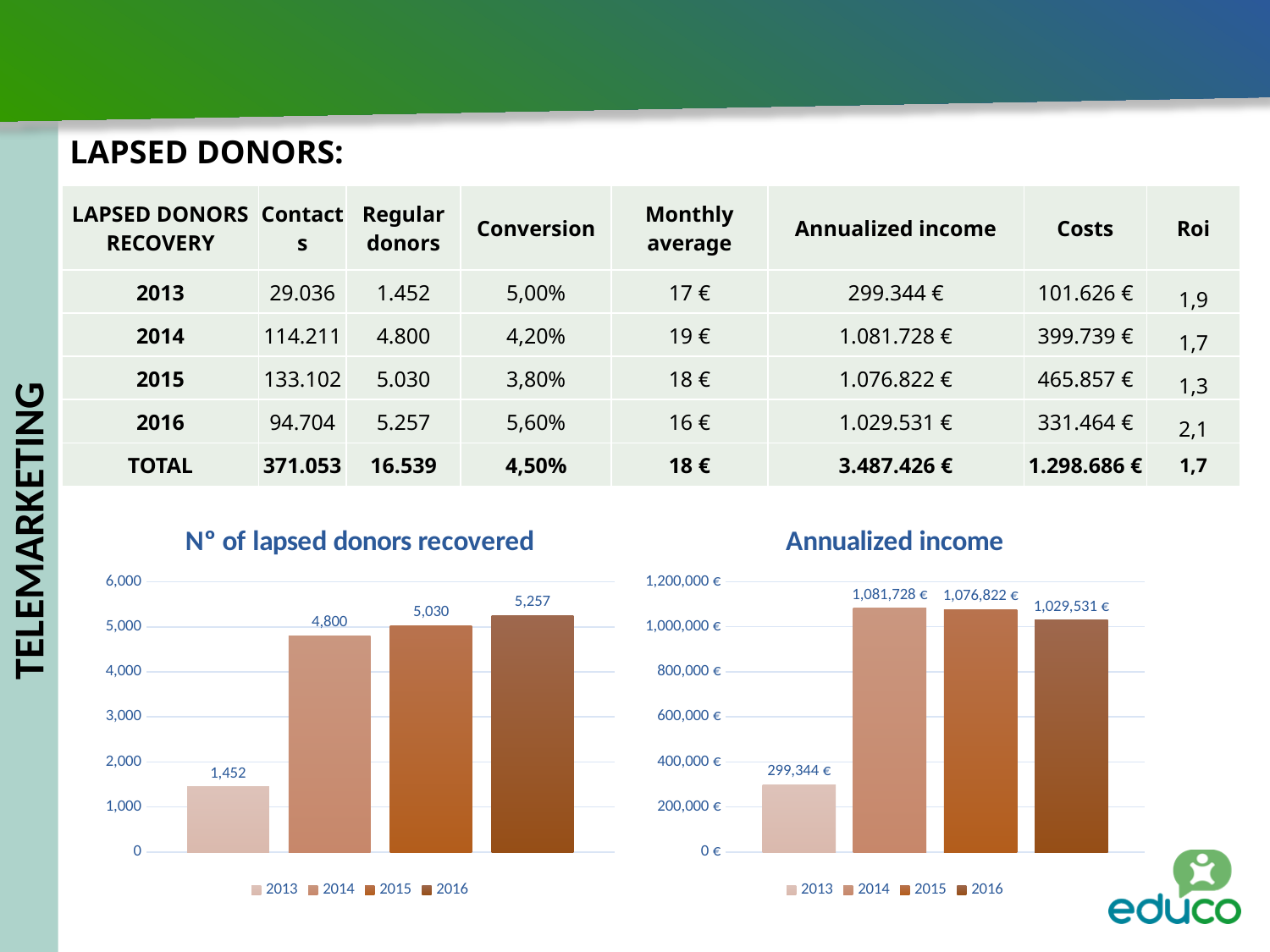
In the 'N° of lapsed donors recovered' chart, what is the difference between the values for 2016 and 2015? 227 In the 'Annualized income' chart, which is larger, the value for 2015 or the value for 2016? 2015 In the 'Annualized income' chart, what is the difference between the values for 2014 and 2013? 782,384 € In the 'N° of lapsed donors recovered' chart, which year has the highest value? 2016 In the 'Annualized income' chart, what is the value for 2013? 299,344 € In the 'N° of lapsed donors recovered' chart, how many bars are plotted? 4 In the 'Annualized income' chart, which year has the highest value? 2014 In the 'N° of lapsed donors recovered' chart, is the value for 2013 greater or less than 2,000? less In the 'Annualized income' chart, how many entries does the legend list? 4 What type of chart is the 'Annualized income' chart? bar chart In the 'N° of lapsed donors recovered' chart, what is the value for 2014? 4,800 In the 'N° of lapsed donors recovered' chart, which year has the lowest value? 2013